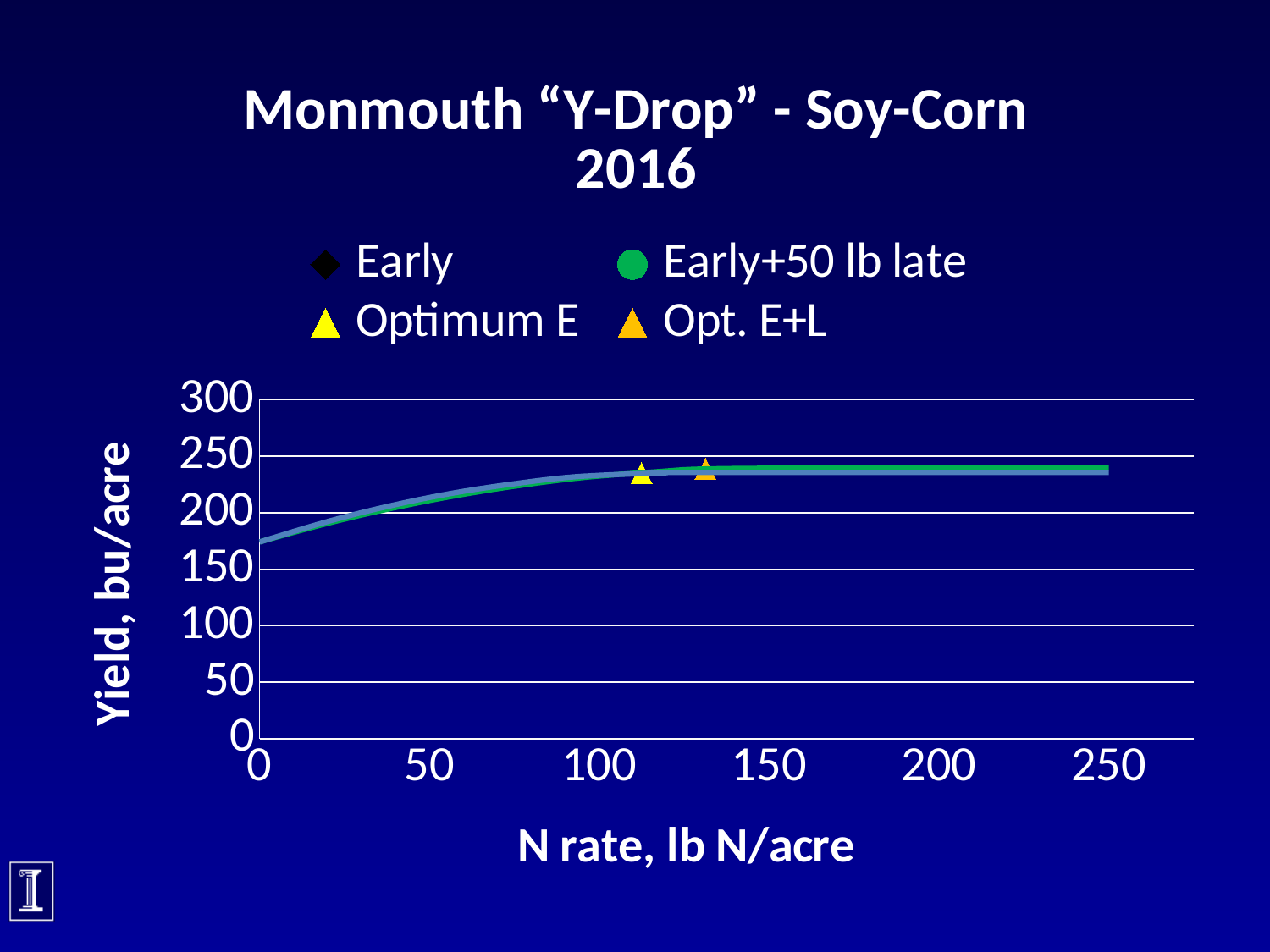
Is the N rate at the Opt. E+L marker greater or less than 100? greater What is the label of the y axis? Yield, bu/acre What kind of chart is shown on the slide? line chart Does the yield rise or fall as the N rate increases from 0 to 250? rise Is the yield at an N rate of 250 greater or less than 250? less Is the yield at the Optimum E marker greater or less than 200? greater How many series does the legend list? 4 What is the title of the chart? Monmouth "Y-Drop" - Soy-Corn 2016